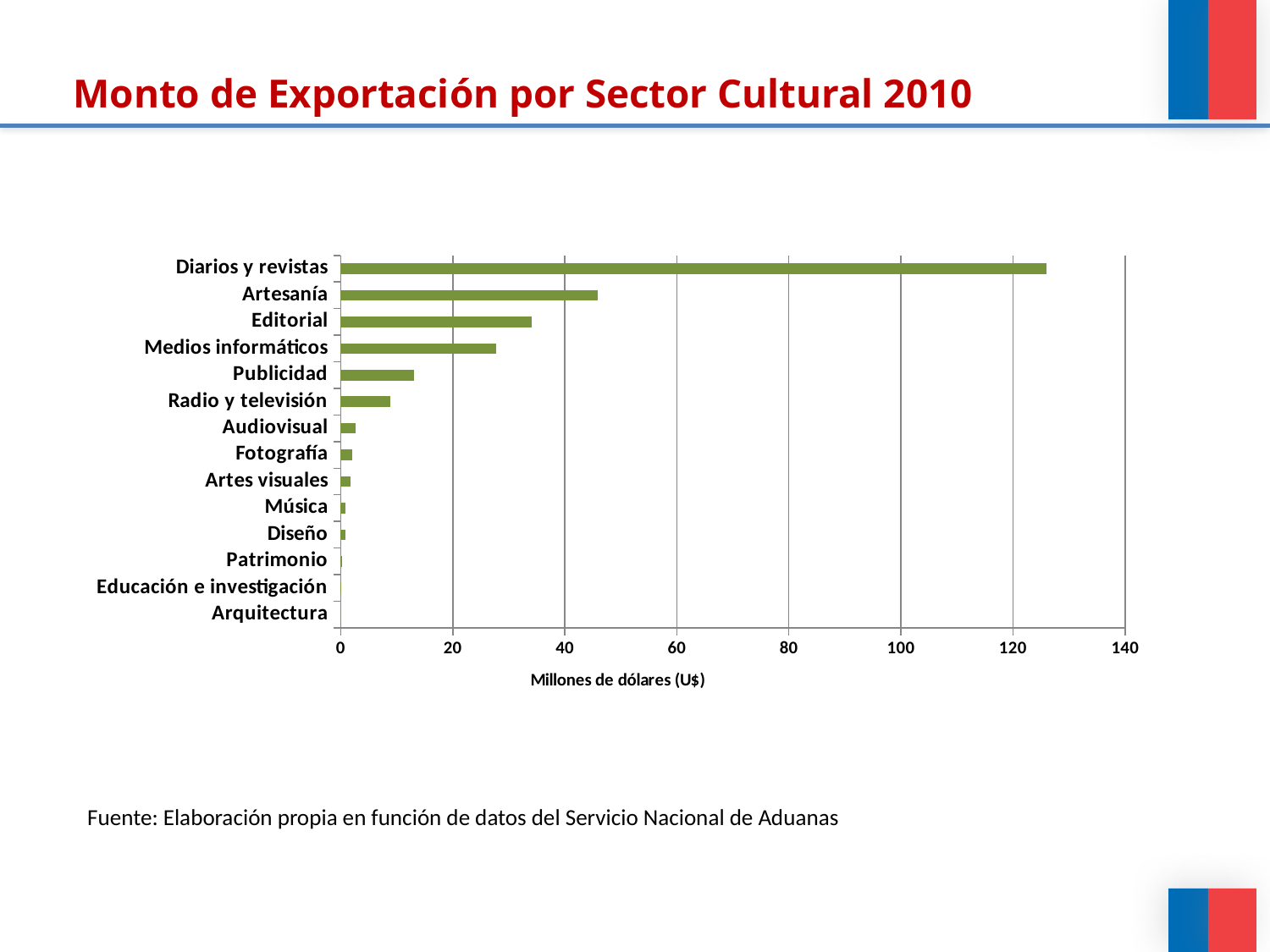
What is the title of the slide? Monto de Exportación por Sector Cultural 2010 What is the label of the horizontal axis? Millones de dólares (U$) Is the value for Publicidad greater or less than 20? less Is the value for Medios informáticos greater or less than 20? greater Is the value for Artesanía greater or less than 40? greater How many cultural sectors are listed on the chart? 14 Which sector has the highest export amount? Diarios y revistas Which is larger, the value for Publicidad or the value for Radio y televisión? Publicidad What kind of chart is shown on the slide? bar chart Which is larger, the value for Artesanía or the value for Editorial? Artesanía